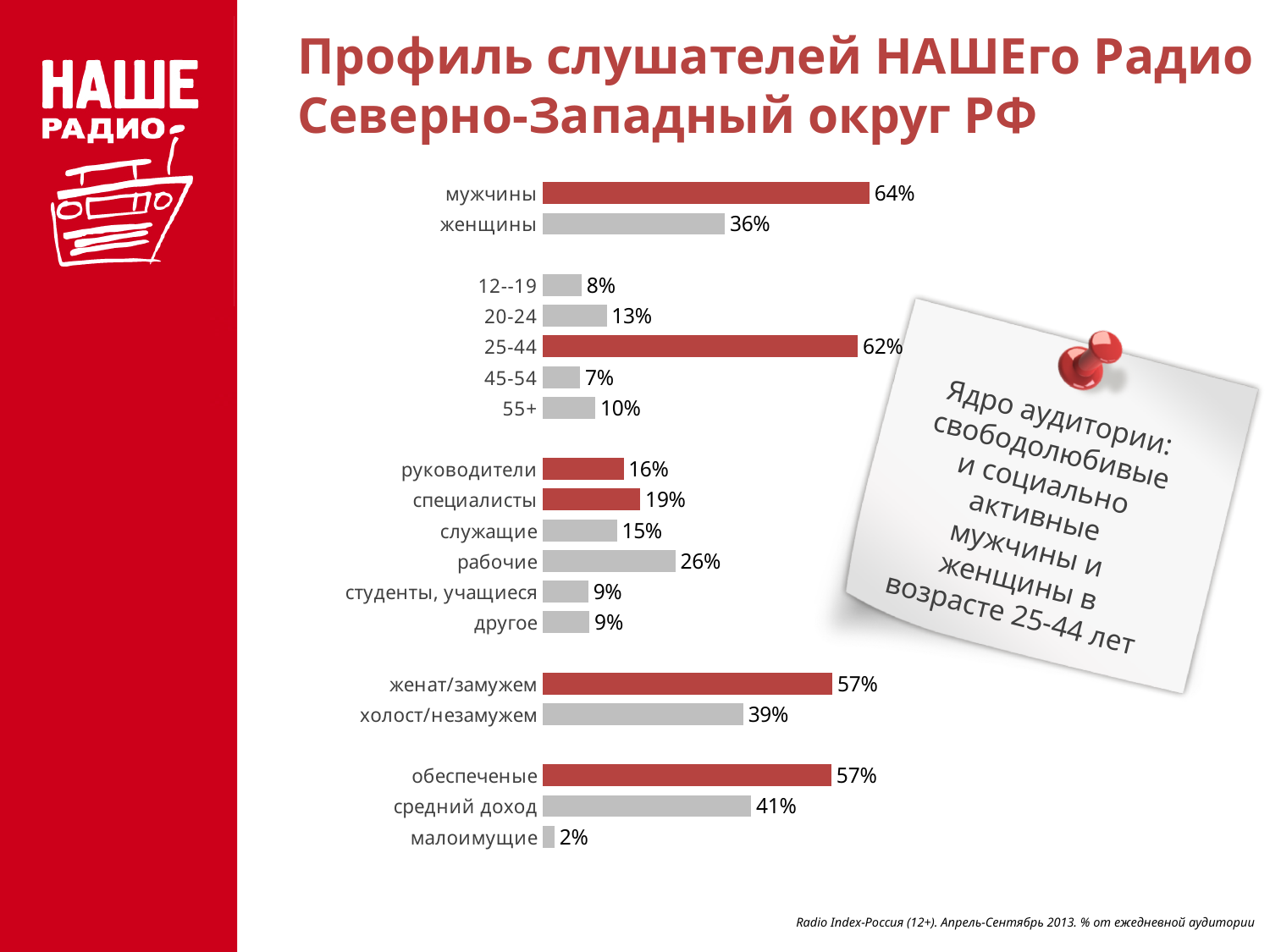
What is the value for the 25-44 age group? 62% How many occupation categories are shown (from руководители to другое)? 6 What is the value for рабочие? 26% What is the value for малоимущие? 2% What is the difference between мужчины and женщины? 28% Which age group has the lowest value? 45-54 What is the difference between женат/замужем and холост/незамужем? 18% Which is larger, обеспеченые or средний доход? обеспеченые What kind of chart is shown on the slide? bar chart What is the value for мужчины? 64% Which is larger, специалисты or руководители? специалисты Which age group has the highest value? 25-44